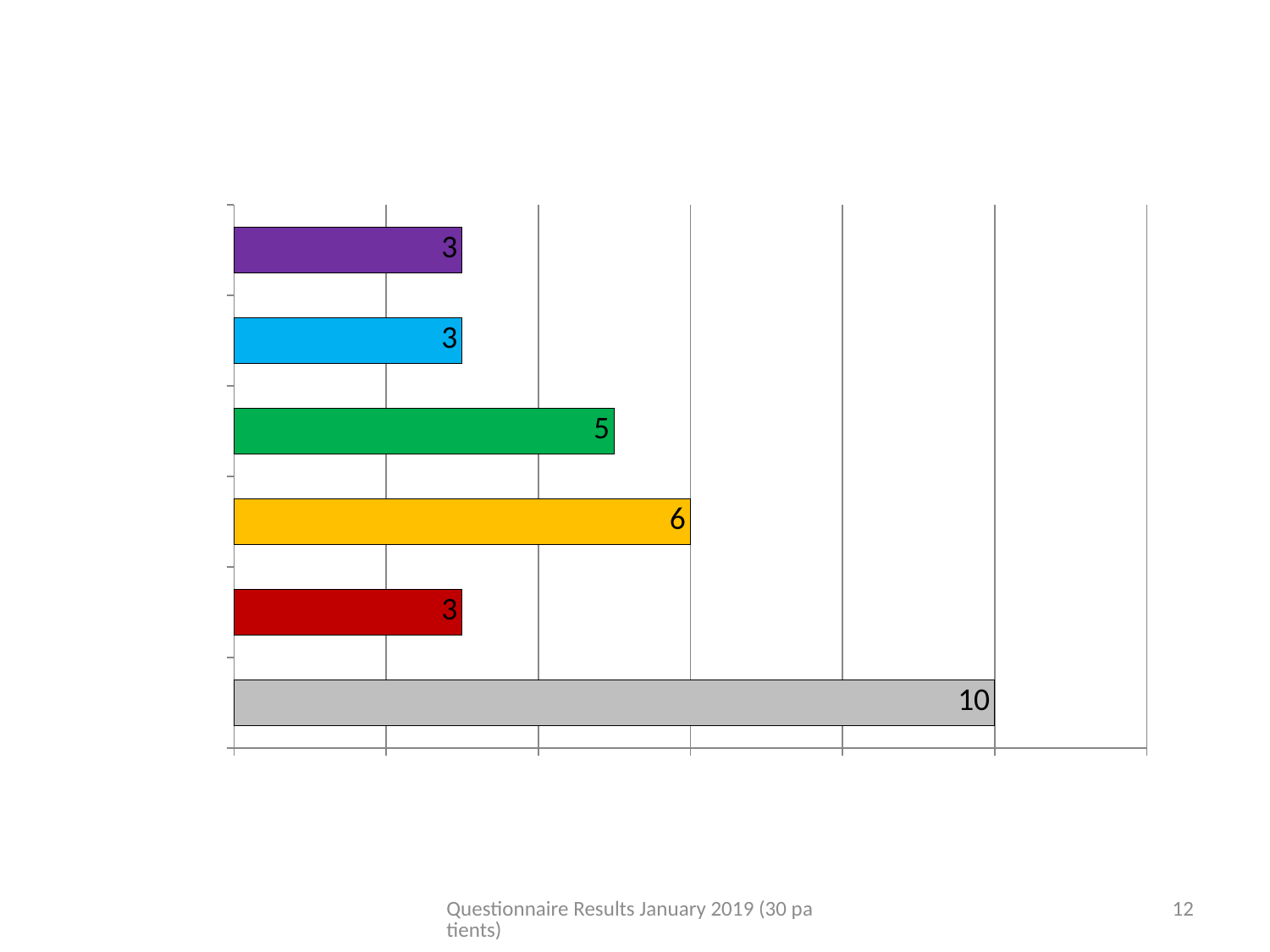
How many bars does the chart show? 6 What is the value of the green bar? 5 What is the value of the yellow bar? 6 What is the highest value shown in the chart? 10 What is the value of the purple bar at the top of the chart? 3 What kind of chart is shown on the slide? bar chart Which is larger, the yellow bar or the green bar? the yellow bar What is the difference between the grey bar and the yellow bar? 4 What is the lowest value shown in the chart? 3 What is the value of the red bar? 3 What is the value of the grey bar at the bottom of the chart? 10 Which bar has the highest value? the grey bar